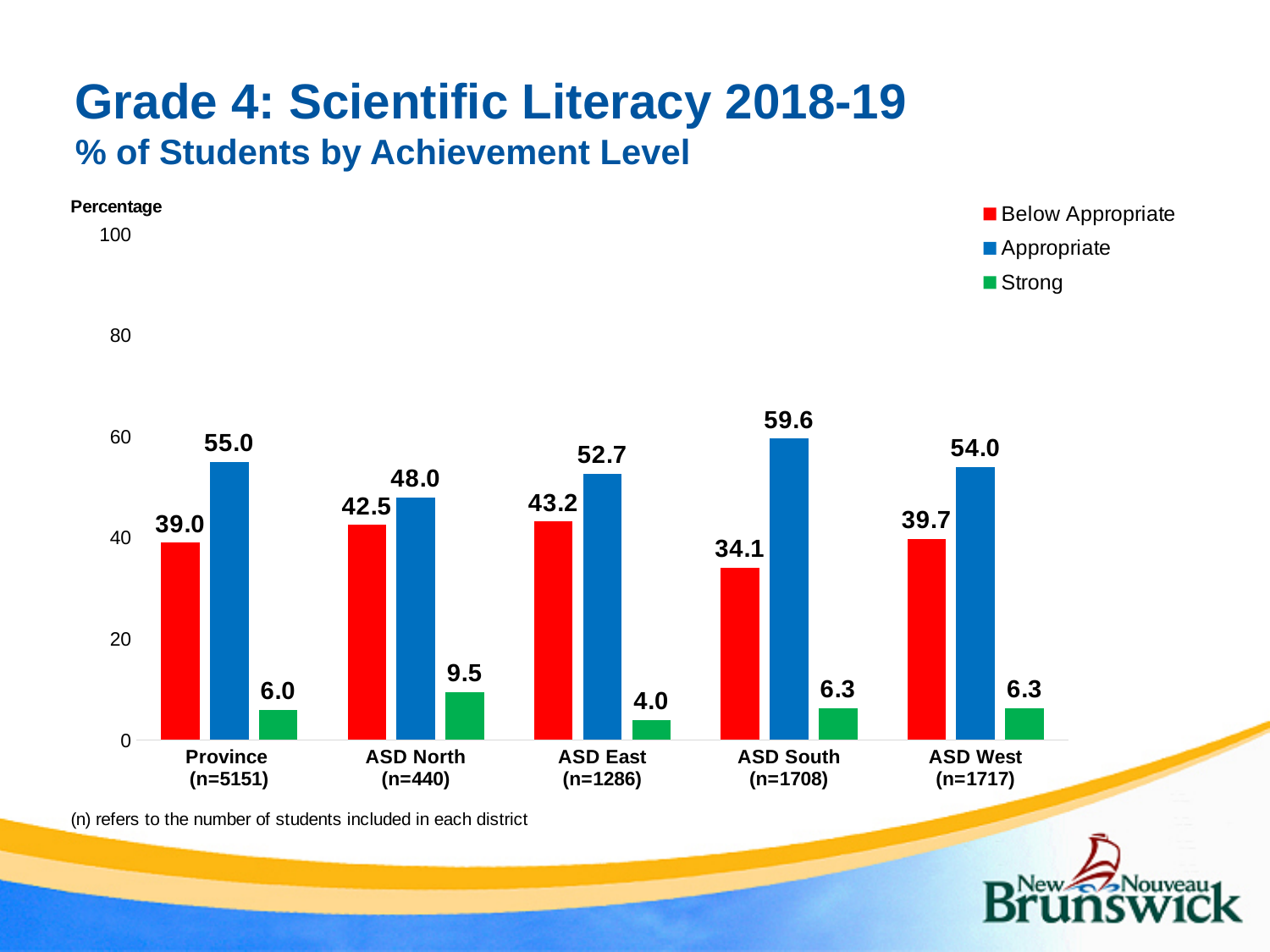
What kind of chart is shown on the slide? Bar chart Which district has the lowest Below Appropriate percentage? ASD South Which district has the lowest Strong percentage? ASD East How many series does the legend list? 3 What is the Strong percentage for ASD North? 9.5 What colour represents the Strong achievement level in the legend? Green What is the difference between the Appropriate and Below Appropriate percentages for the Province? 16.0 What is the Below Appropriate percentage for ASD East? 43.2 What is the Appropriate percentage for ASD South? 59.6 Which is larger, the Below Appropriate percentage for ASD North or for ASD West? ASD North Which district has the highest Appropriate percentage? ASD South How many districts (categories) are shown on the x axis? 5